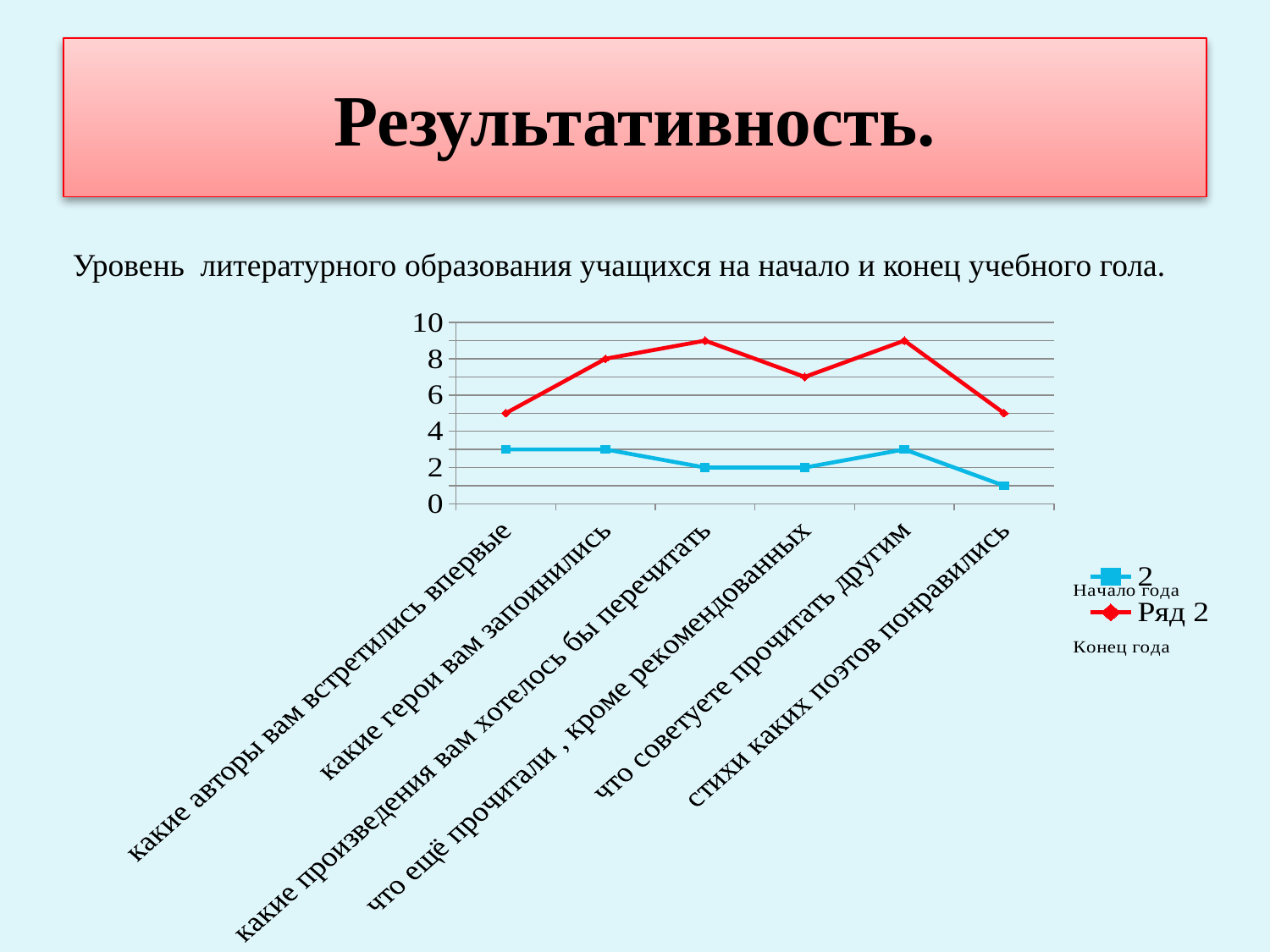
Does the red series rise or fall from "что советуете прочитать другим" to "стихи каких поэтов понравились"? fall What type of chart is shown on the slide? line chart How many categories are plotted along the x axis of the chart? 6 How many series does the chart's legend list? 2 For the category "что советуете прочитать другим", which series has the larger value, the red one or the blue one? the red one (Ряд 2) What is the value of the blue series (Начало года) for the category "какие произведения вам хотелось бы перечитать"? 2 What is the value of the red series (Ряд 2, Конец года) for the category "какие герои вам запомнились"? 8 Is the value of the blue series for "стихи каких поэтов понравились" greater or less than 2? less What is the value of the blue series (Начало года) for the category "что ещё прочитали, кроме рекомендованных"? 2 For which category is the blue series (Начало года) lowest? стихи каких поэтов понравились Is the value of the red series for "какие авторы вам встретились впервые" greater or less than 4? greater Is the value of the red series for "что советуете прочитать другим" greater or less than 6? greater